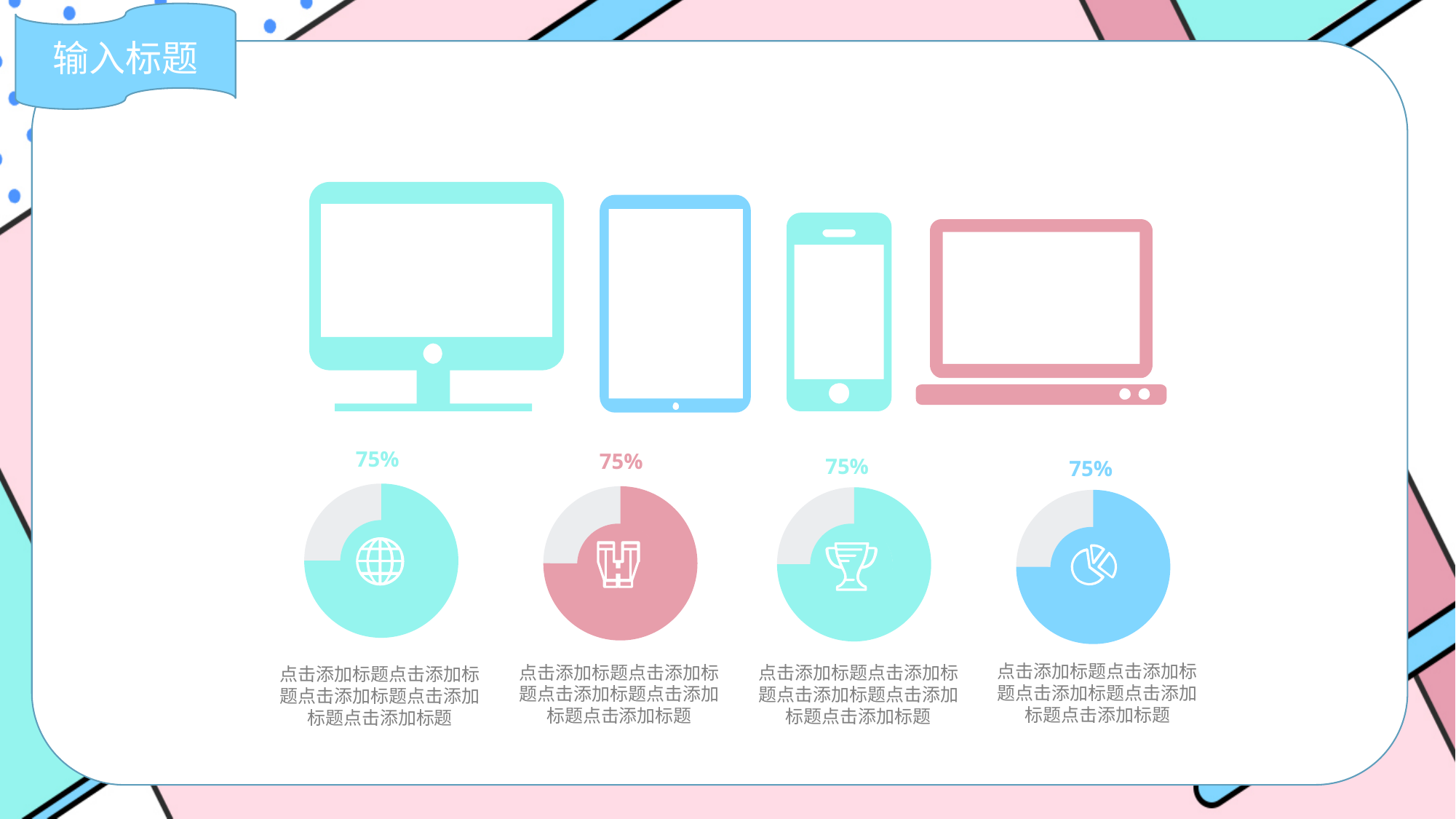
Do the four pie charts show the same value or different values? the same value What colour is the filled segment of the rightmost pie chart? blue How many pie charts are on the slide? 4 Is the value shown for the leftmost pie chart greater or less than 50%? greater What kind of chart is used for the four figures in the lower half of the slide? doughnut chart What colour is the filled segment of the second pie chart from the left? pink What percentage is shown above the rightmost pie chart (the one with the pie-slice icon)? 75% What percentage is shown above the third pie chart from the left (the one with the trophy icon)? 75% What percentage is shown above the second pie chart from the left (the one with the binoculars icon)? 75% What share of the leftmost pie chart is filled with the coloured (non-grey) segment? 75% What percentage is shown above the leftmost pie chart (the one with the globe icon)? 75% Is the value shown for the rightmost pie chart greater or less than 100%? less